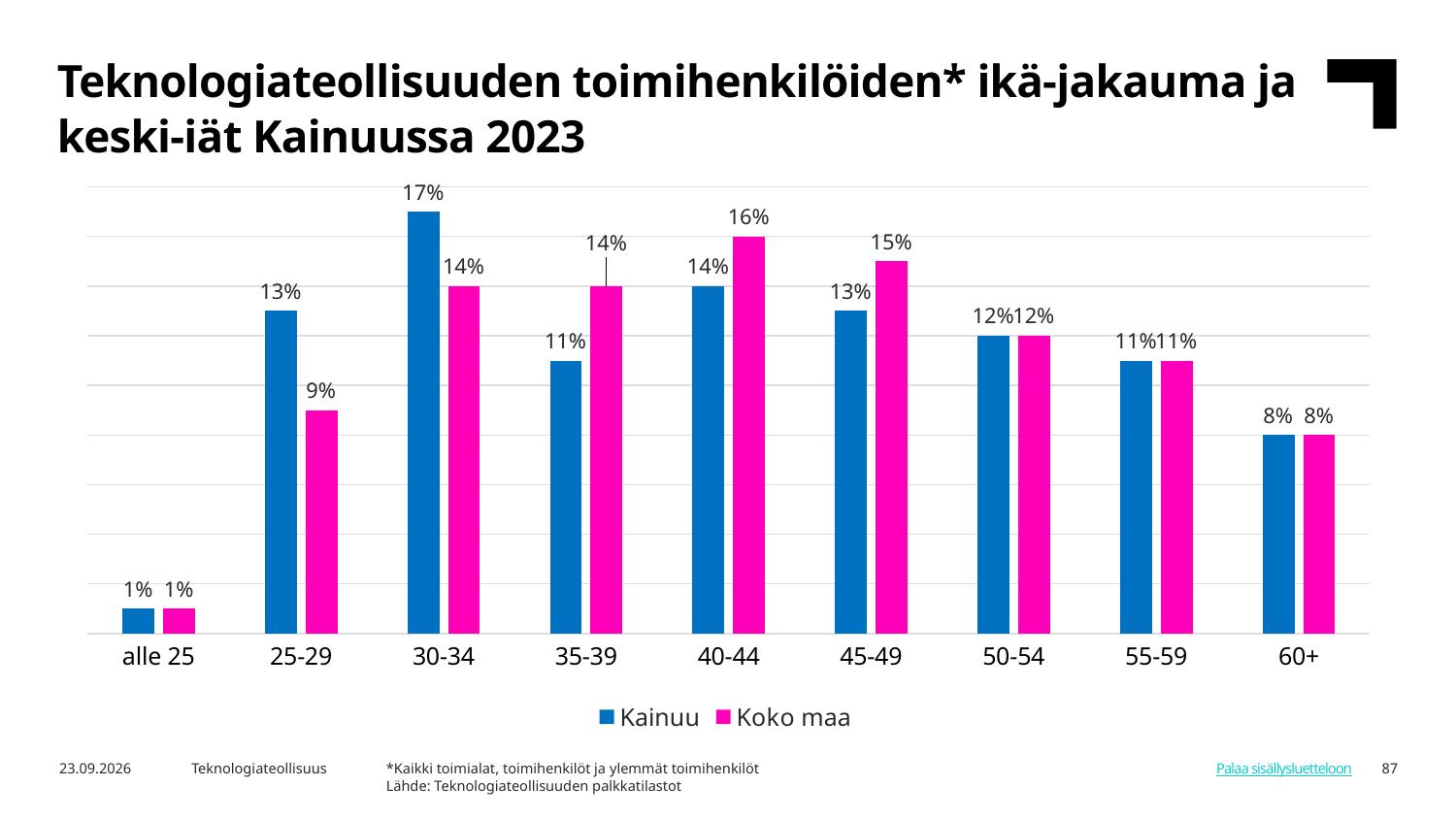
Do the Kainuu values rise or fall from the 45-49 age group to the 60+ age group? Fall Which age group has the highest Kainuu value? 30-34 Which colour represents the Koko maa series? Pink For the 35-39 age group, which series has the larger value, Kainuu or Koko maa? Koko maa What is the Koko maa value for the 25-29 age group? 9% How many series does the legend list? 2 What is the Koko maa value for the 40-44 age group? 16% Which age group has the lowest Koko maa value? alle 25 What kind of chart is shown on the slide? Bar chart What is the difference between the Kainuu and Koko maa values for the 25-29 age group? 4 percentage points How many age groups are shown on the x axis? 9 What is the Kainuu value for the 30-34 age group? 17%